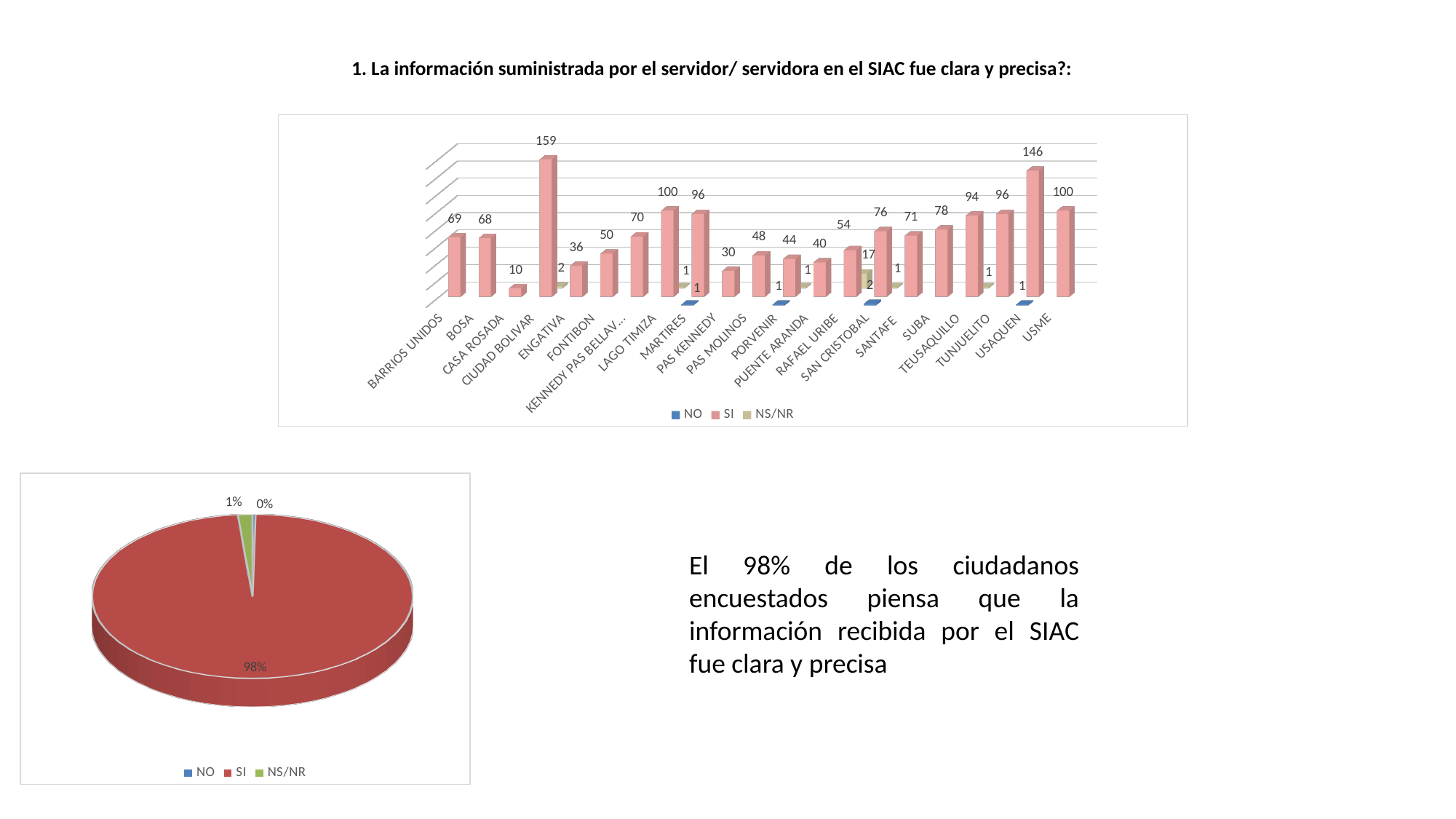
In the top bar chart, what is the SI value for CASA ROSADA? 10 In the top bar chart, what is the SI value for USAQUEN? 146 In the top bar chart, how many series does the legend list? 3 In the top bar chart, which category has the lowest SI value? CASA ROSADA In the bottom pie chart, what share does NS/NR have? 1% In the top bar chart, what is the SI value for CIUDAD BOLIVAR? 159 In the top bar chart, which has a larger SI value, TEUSAQUILLO or SUBA? TEUSAQUILLO In the top bar chart, what is the difference between the SI values for CIUDAD BOLIVAR and USAQUEN? 13 In the top bar chart, which category has the highest SI value? CIUDAD BOLIVAR In the top bar chart, how many categories are shown on the x axis? 21 What kind of chart is the chart at the bottom left of the slide? Pie chart In the bottom pie chart, what share does SI have? 98%